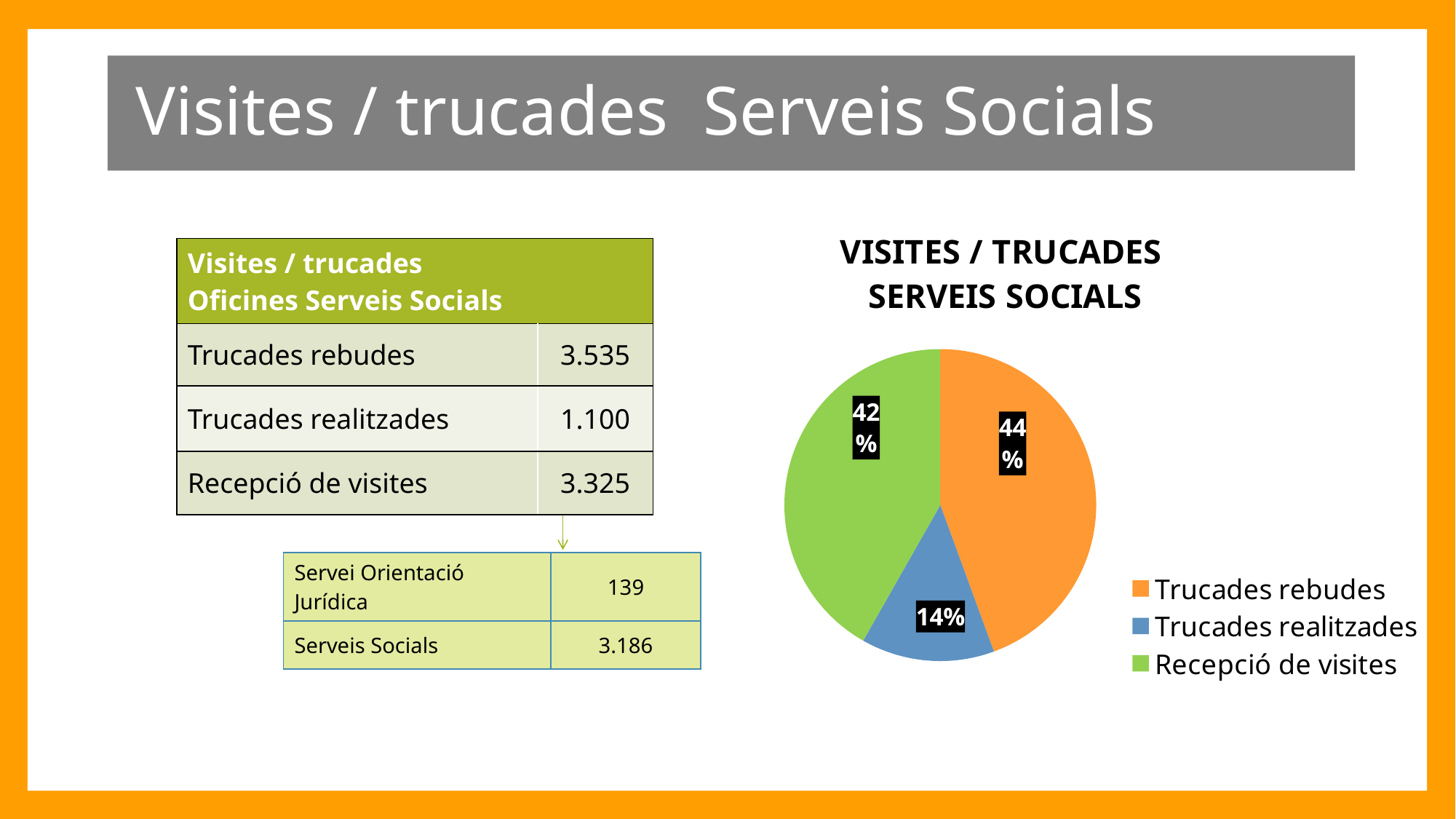
What is the title of the pie chart? VISITES / TRUCADES SERVEIS SOCIALS What share of the pie does Trucades rebudes represent? 44% How many entries does the pie chart legend list? 3 Which is larger in the pie chart, Trucades realitzades or Recepció de visites? Recepció de visites What share of the pie does Trucades realitzades represent? 14% What kind of chart is shown on the slide? pie chart What colour is the Recepció de visites slice in the pie chart? green What share of the pie does Recepció de visites represent? 42% Which slice of the pie chart is the smallest? Trucades realitzades How many slices does the pie chart have? 3 What is the difference in percentage points between the Trucades rebudes slice and the Trucades realitzades slice? 30% Which slice of the pie chart is the largest? Trucades rebudes